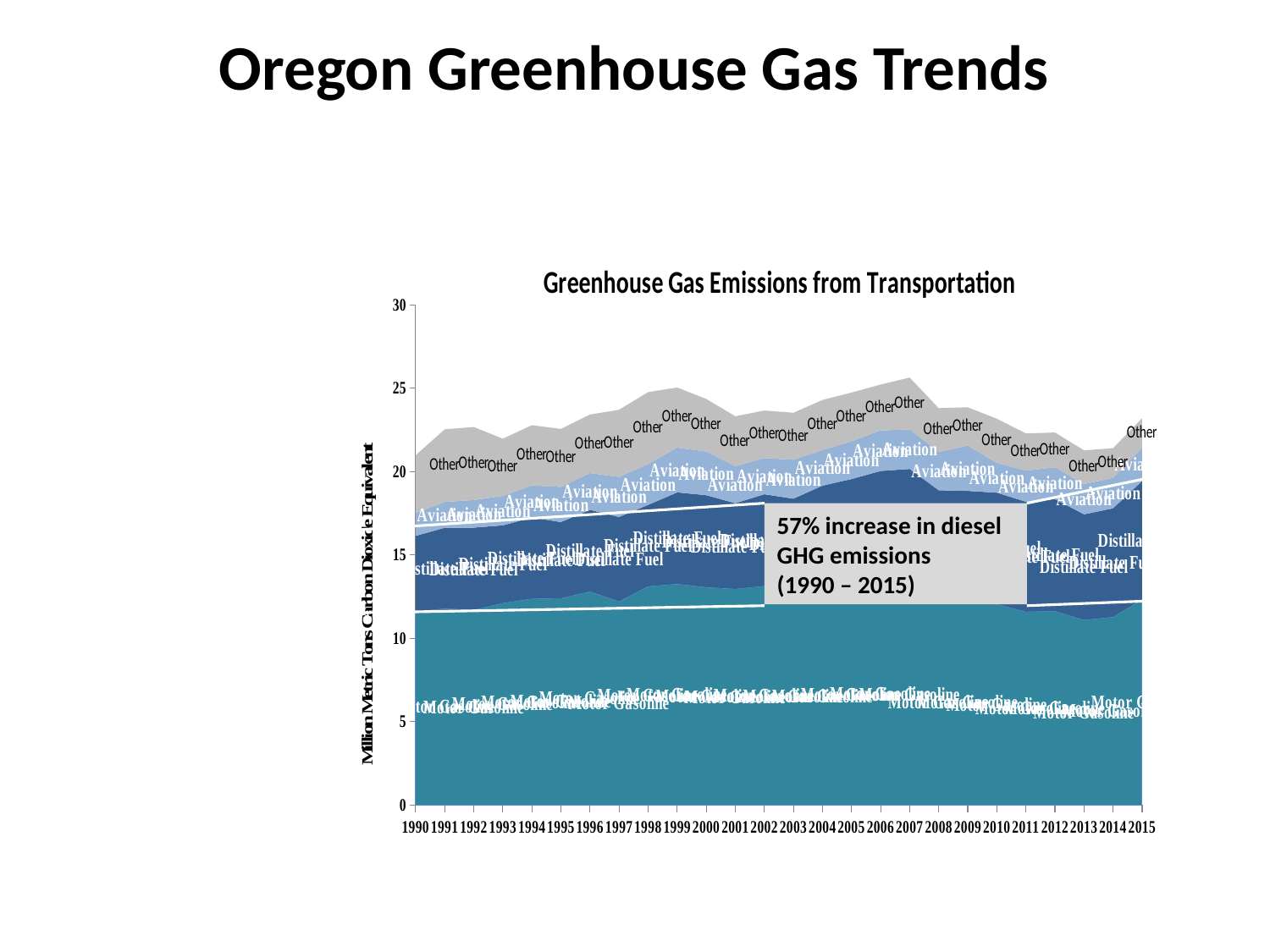
What is the title of the chart? Greenhouse Gas Emissions from Transportation What kind of chart is shown on the slide? Stacked area chart Is the total transportation emissions value for 1990 greater or less than 20? greater Is the Motor Gasoline value for 2015 greater or less than 10? greater What is the label on the vertical axis of the chart? Million Metric Tons Carbon Dioxide Equivalent How many fuel categories (series) are stacked in the chart? 4 Do total transportation emissions rise or fall between 2007 and 2013? fall Which series forms the bottom (largest) layer of the stacked area chart? Motor Gasoline Is the total transportation emissions value for 2013 greater or less than 25? less According to the callout on the chart, by what percentage did diesel GHG emissions increase from 1990 to 2015? 57% How many years are plotted along the x axis of the chart? 26